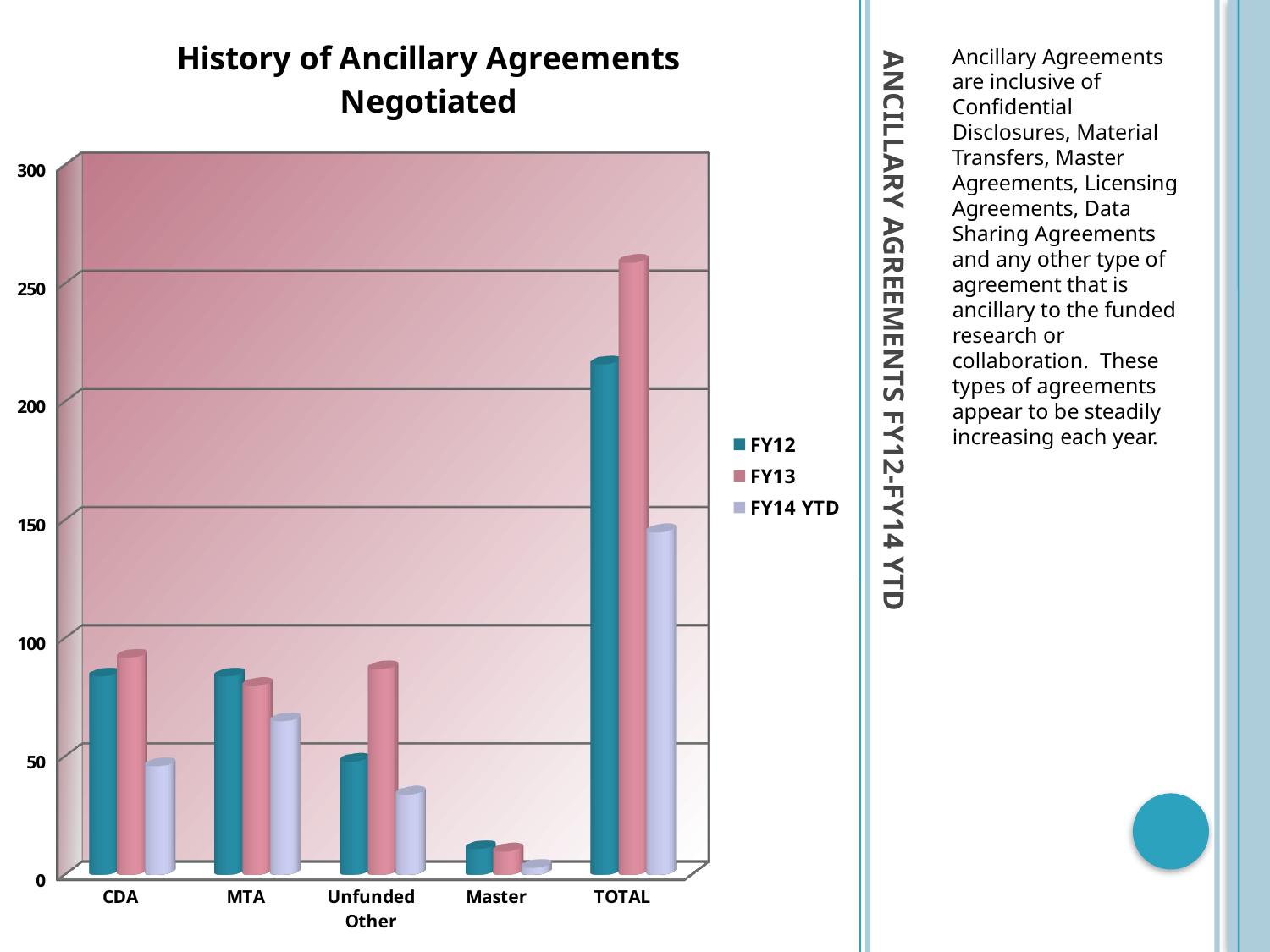
How many categories are shown on the x axis? 5 Which category has the lowest FY12 value? Master Is the FY12 value for Master greater or less than 50? less Is the FY13 value for TOTAL greater or less than 250? greater For CDA, which is larger: the FY13 value or the FY14 YTD value? FY13 What is the title of the chart? History of Ancillary Agreements Negotiated Is the FY12 value for TOTAL greater or less than 200? greater Which category has the highest FY13 value? TOTAL Which series are listed in the legend? FY12, FY13, FY14 YTD How many series does the legend list? 3 For Unfunded Other, which is larger: the FY12 value or the FY13 value? FY13 What kind of chart is shown on the slide? bar chart